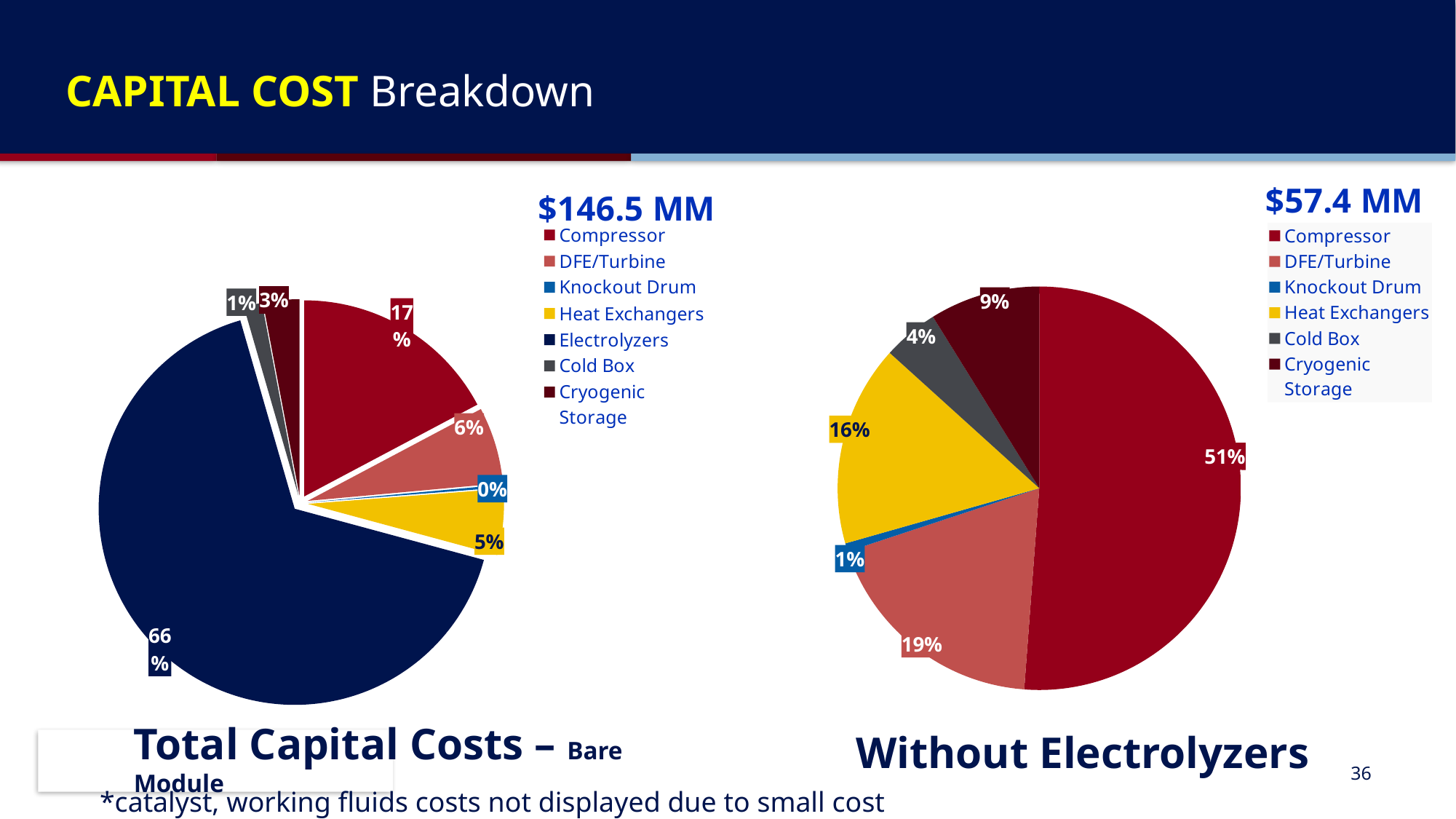
How many entries does the legend of the right pie chart (Without Electrolyzers) list? 6 How many slices are labelled in the left pie chart (Total Capital Costs – Bare Module)? 7 What total capital cost is shown above the right pie chart (Without Electrolyzers)? $57.4 MM In the right pie chart (Without Electrolyzers), what is the difference between the DFE/Turbine share and the Cryogenic Storage share? 10% In the left pie chart (Total Capital Costs – Bare Module), which category has the smallest slice? Knockout Drum What type of chart is used on this slide? Pie chart In the right pie chart (Without Electrolyzers), what share does the Compressor account for? 51% In the left pie chart (Total Capital Costs – Bare Module), what share do Electrolyzers account for? 66% In the left pie chart (Total Capital Costs – Bare Module), which is larger: the DFE/Turbine slice or the Heat Exchangers slice? DFE/Turbine In the right pie chart (Without Electrolyzers), which category has the largest slice? Compressor In the left pie chart (Total Capital Costs – Bare Module), what share does the Compressor account for? 17%